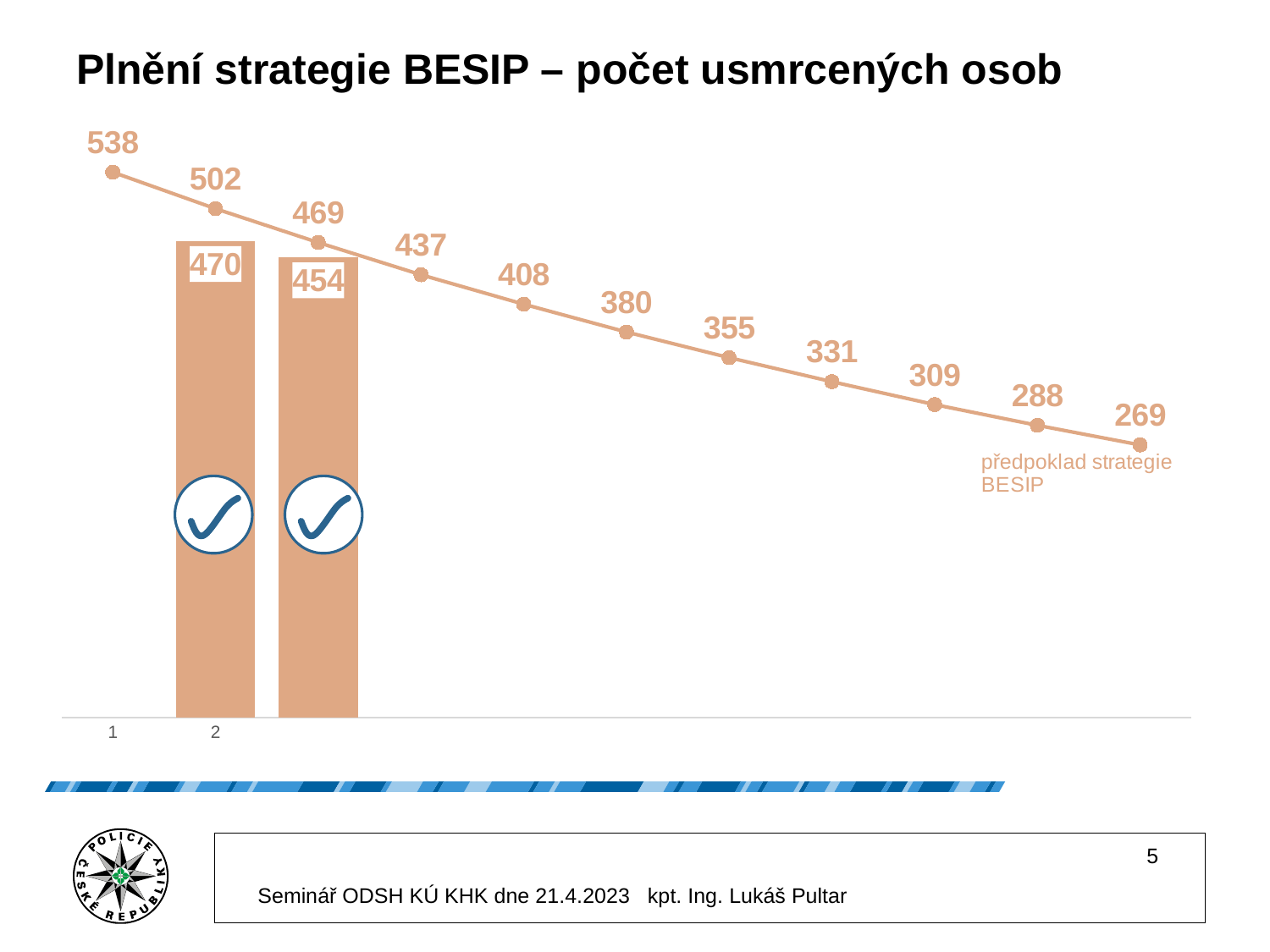
How many bars are plotted in the chart? 2 How many data points are plotted on the line? 11 Which point on the line has the highest value? The first point, 538 What is the value of the last (rightmost) point on the line? 269 What is the difference between the two bar values, 470 and 454? 16 What is the value of the right bar? 454 What is the value of the left bar? 470 What is the value of the first (leftmost) point on the line? 538 What kind of chart is shown on the slide? A combined line and bar chart What label is shown next to the line? předpoklad strategie BESIP What is the title of the chart? Plnění strategie BESIP – počet usmrcených osob Do the values on the line rise or fall from left to right? Fall